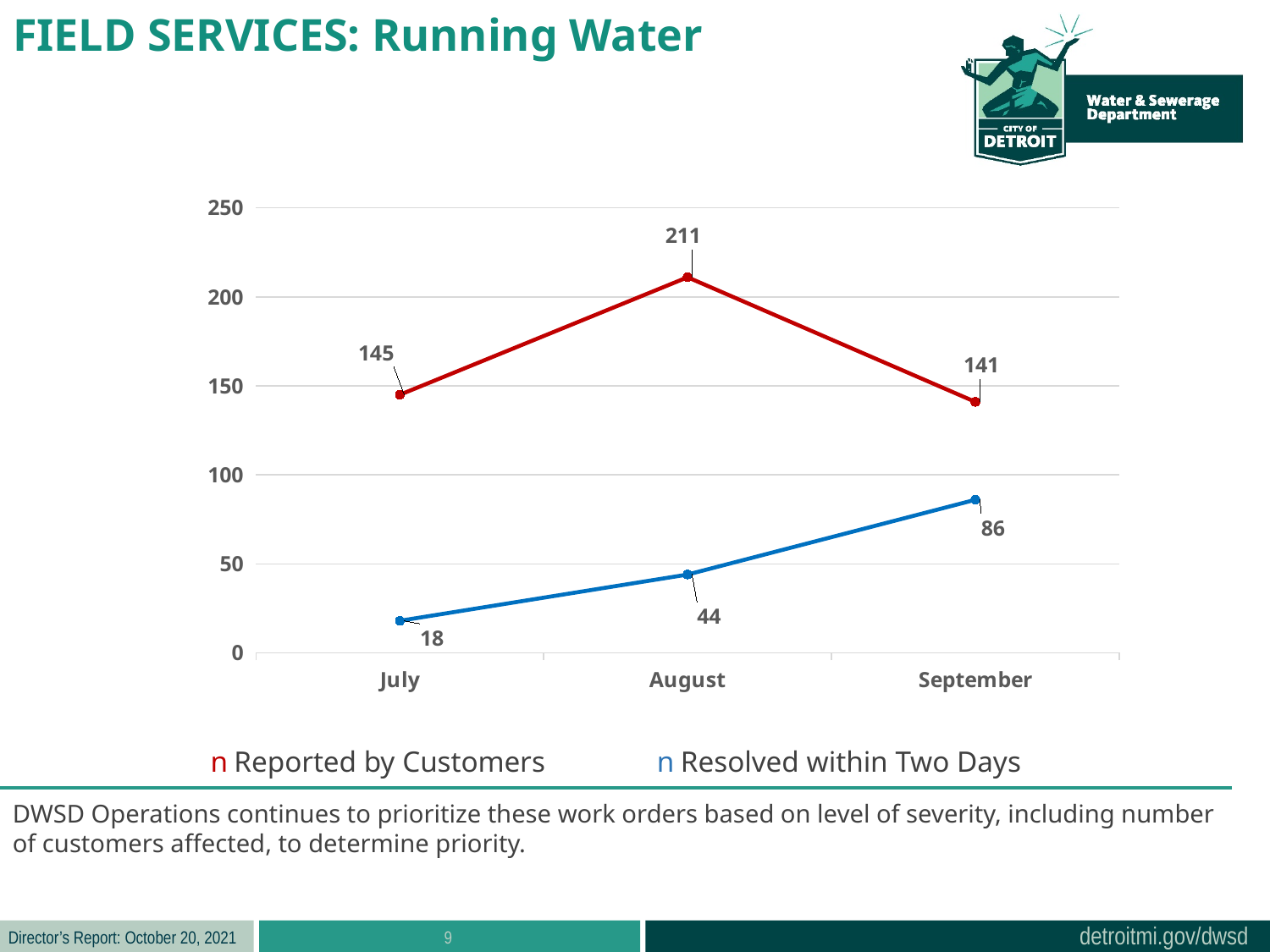
What is the difference between Reported by Customers in August and in July? 66 What is the value for Reported by Customers in August? 211 Is the value for Reported by Customers in August greater or less than 200? greater What is the value for Reported by Customers in September? 141 Which is larger: Resolved within Two Days in August or in September? September In which month is Resolved within Two Days lowest? July In which month is Reported by Customers highest? August What is the value for Resolved within Two Days in July? 18 How many series does the legend list? 2 What is the difference between Reported by Customers and Resolved within Two Days in September? 55 How many months are shown on the x axis? 3 What kind of chart is shown on the slide? line chart